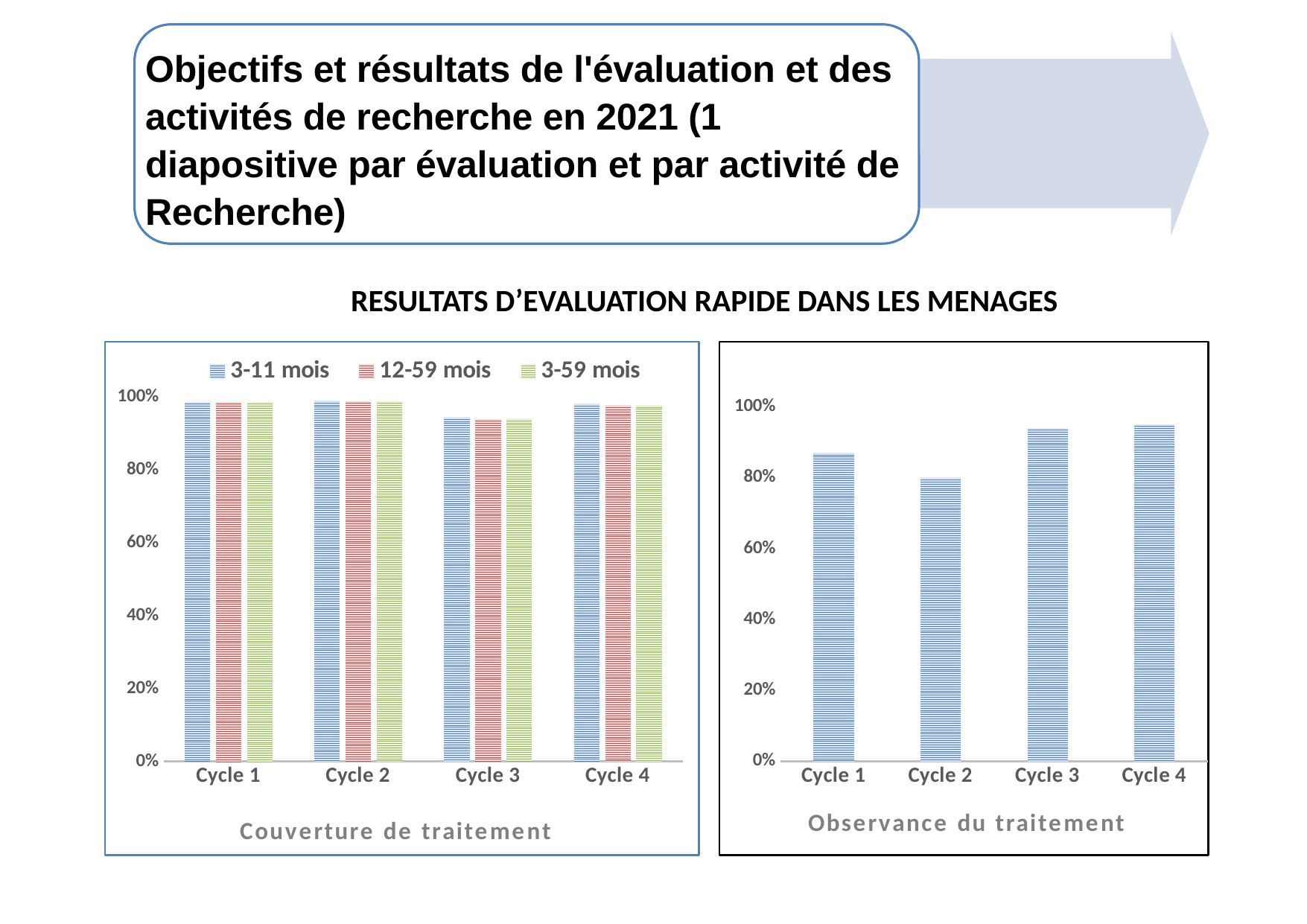
In the 'Observance du traitement' chart, is the value for Cycle 2 greater or less than 60%? greater How many series does the legend of the 'Couverture de traitement' chart list? 3 What are the legend entries of the 'Couverture de traitement' chart? 3-11 mois, 12-59 mois, 3-59 mois In the 'Observance du traitement' chart, is the value for Cycle 1 greater or less than 80%? greater In the 'Couverture de traitement' chart, is the value for 3-11 mois in Cycle 3 greater or less than 80%? greater In the 'Observance du traitement' chart, which is larger, the value for Cycle 3 or the value for Cycle 2? Cycle 3 How many cycles are shown on the x axis of the 'Observance du traitement' chart? 4 What kind of chart is the 'Observance du traitement' chart? bar chart In the 'Observance du traitement' chart, which is larger, the value for Cycle 1 or the value for Cycle 2? Cycle 1 What is the title shown above the two charts? RESULTATS D’EVALUATION RAPIDE DANS LES MENAGES In the 'Couverture de traitement' chart, which cycle has the lowest values across the series? Cycle 3 In the 'Observance du traitement' chart, which cycle has the lowest value? Cycle 2